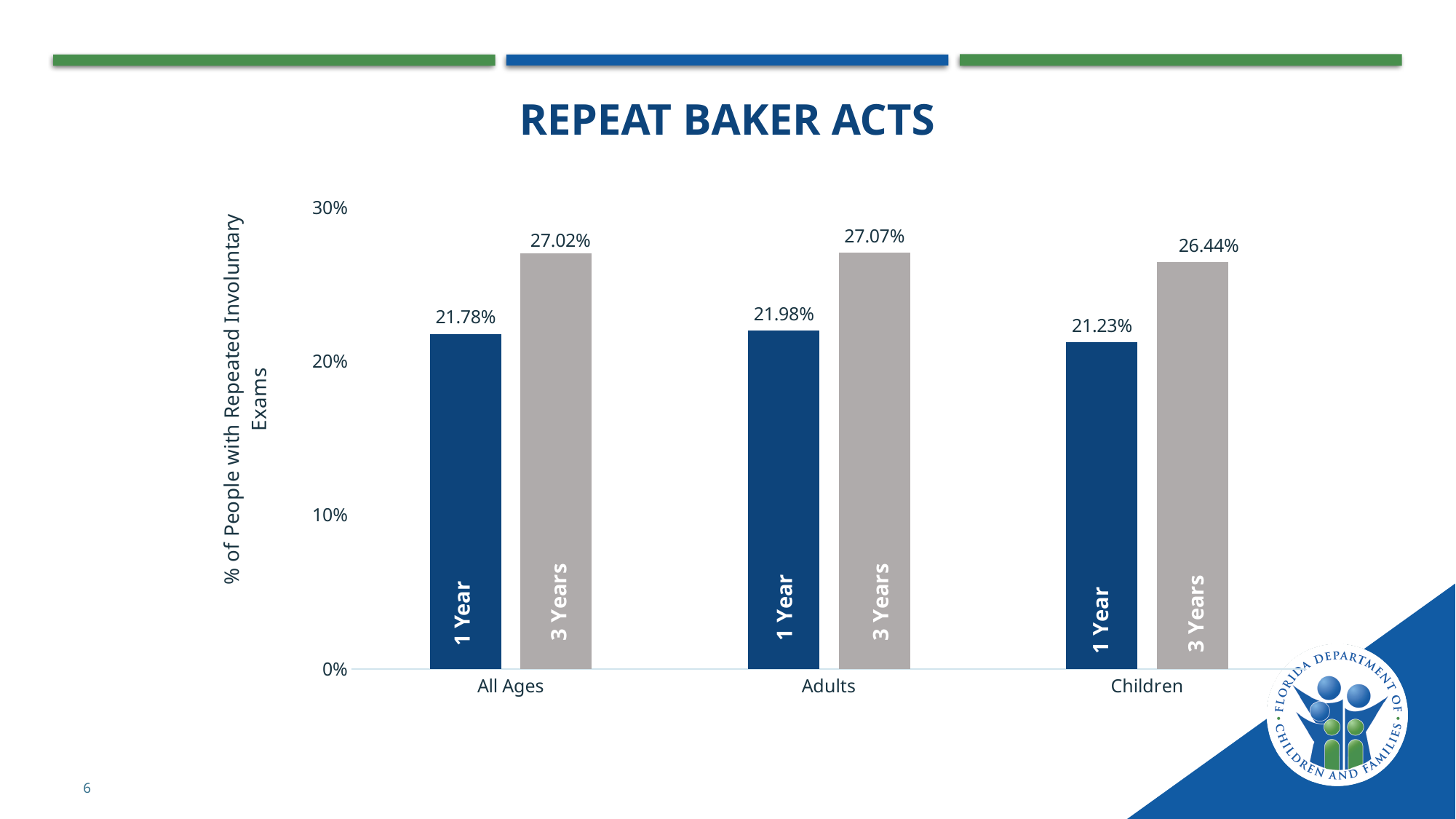
Which is larger for Adults: the 1 Year value or the 3 Years value? 3 Years What is the difference between the 3 Years and 1 Year values for All Ages? 5.24% What is the 1 Year value for Children? 21.23% How many series (bars per category) are plotted? 2 What is the 3 Years value for Adults? 27.07% Which category has the lowest 1 Year value? Children How many age categories are shown on the x axis? 3 What is the 1 Year value for All Ages? 21.78% Is the 3 Years value for Children greater or less than 30%? less What type of chart is shown on the slide? Bar chart What is the 3 Years value for Children? 26.44% What is the title of the chart? REPEAT BAKER ACTS